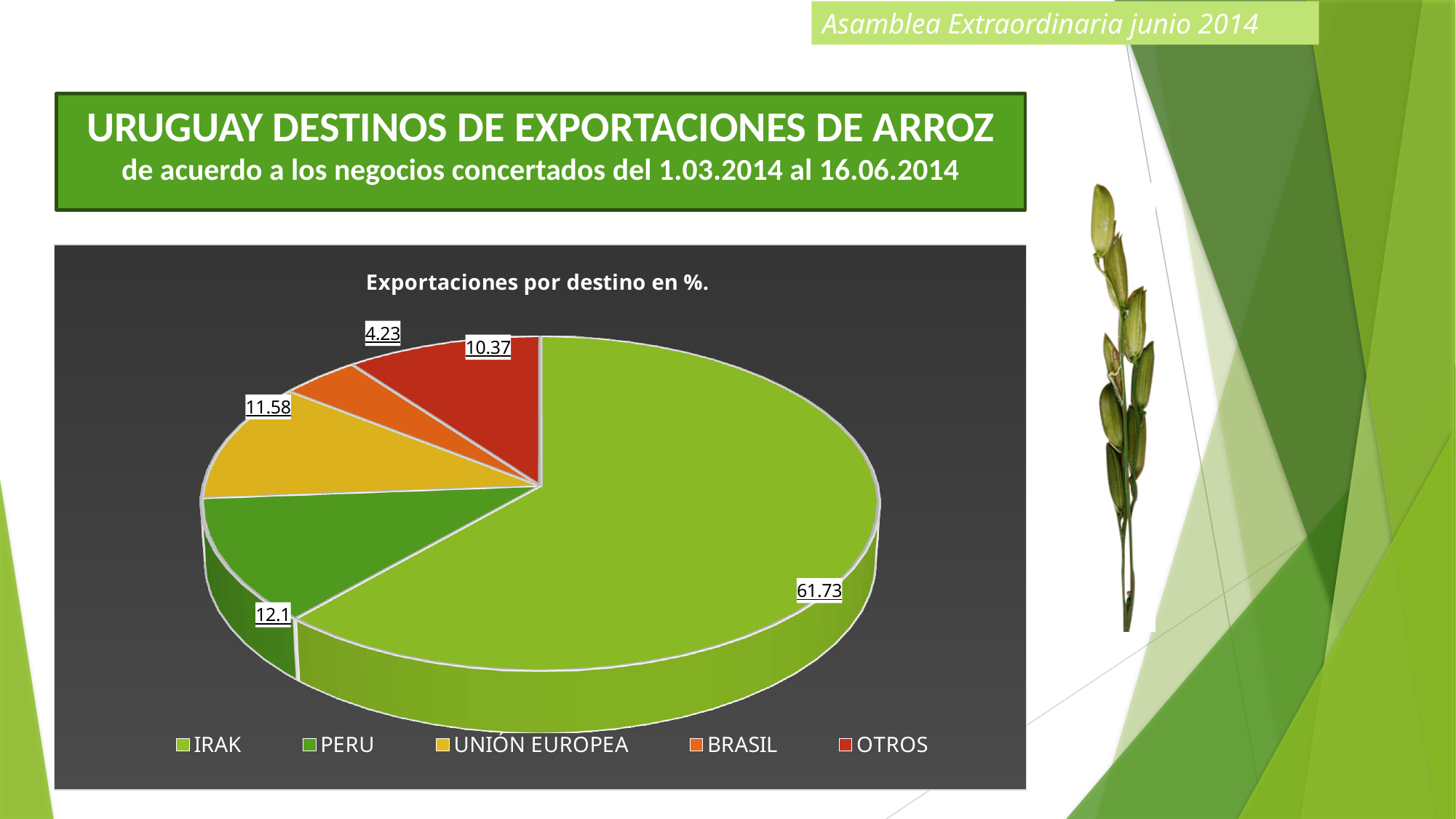
Which destination has the smallest share? BRASIL What is the value for OTROS? 10.37 Which is larger, the value for OTROS or the value for BRASIL? OTROS What is the value for IRAK? 61.73 What is the value for PERU? 12.1 What is the value for UNIÓN EUROPEA? 11.58 What is the value for BRASIL? 4.23 What is the title of the chart? Exportaciones por destino en %. Which destination has the largest share? IRAK What is the difference between the values for IRAK and PERU? 49.63 How many destinations does the legend list? 5 What type of chart is shown on the slide? pie chart